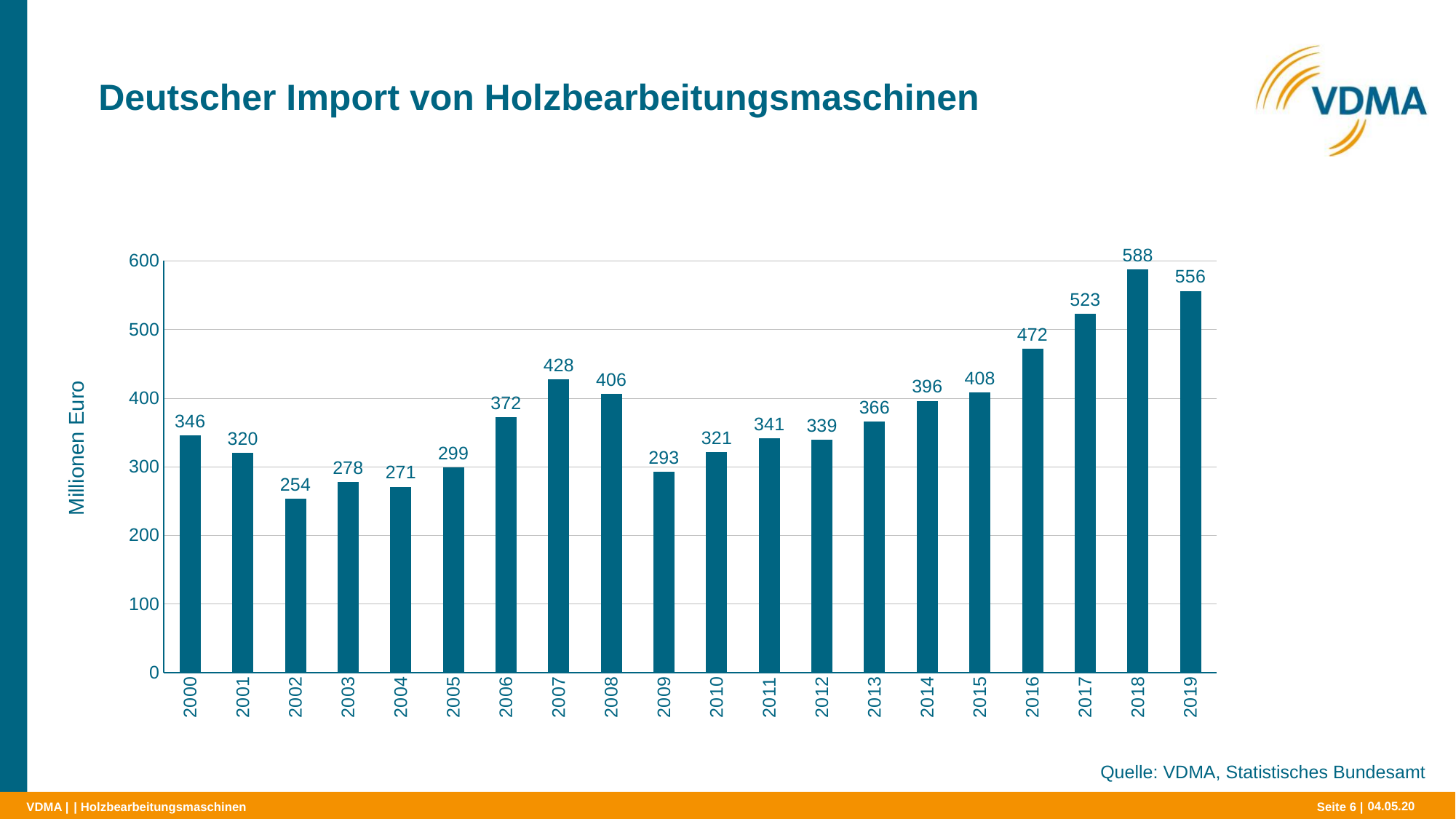
What is the value for 2007? 428 What is the difference between the values for 2018 and 2019? 32 Which year has the lowest value? 2002 What is the difference between the values for 2008 and 2009? 113 How many years are shown on the x axis? 20 Which is larger, the value for 2011 or the value for 2012? 2011 What is the value for 2019? 556 What is the label of the y axis? Millionen Euro Is the value for 2016 greater or less than 400? greater What kind of chart is shown on the slide? bar chart What is the value for 2002? 254 Which year has the highest value? 2018